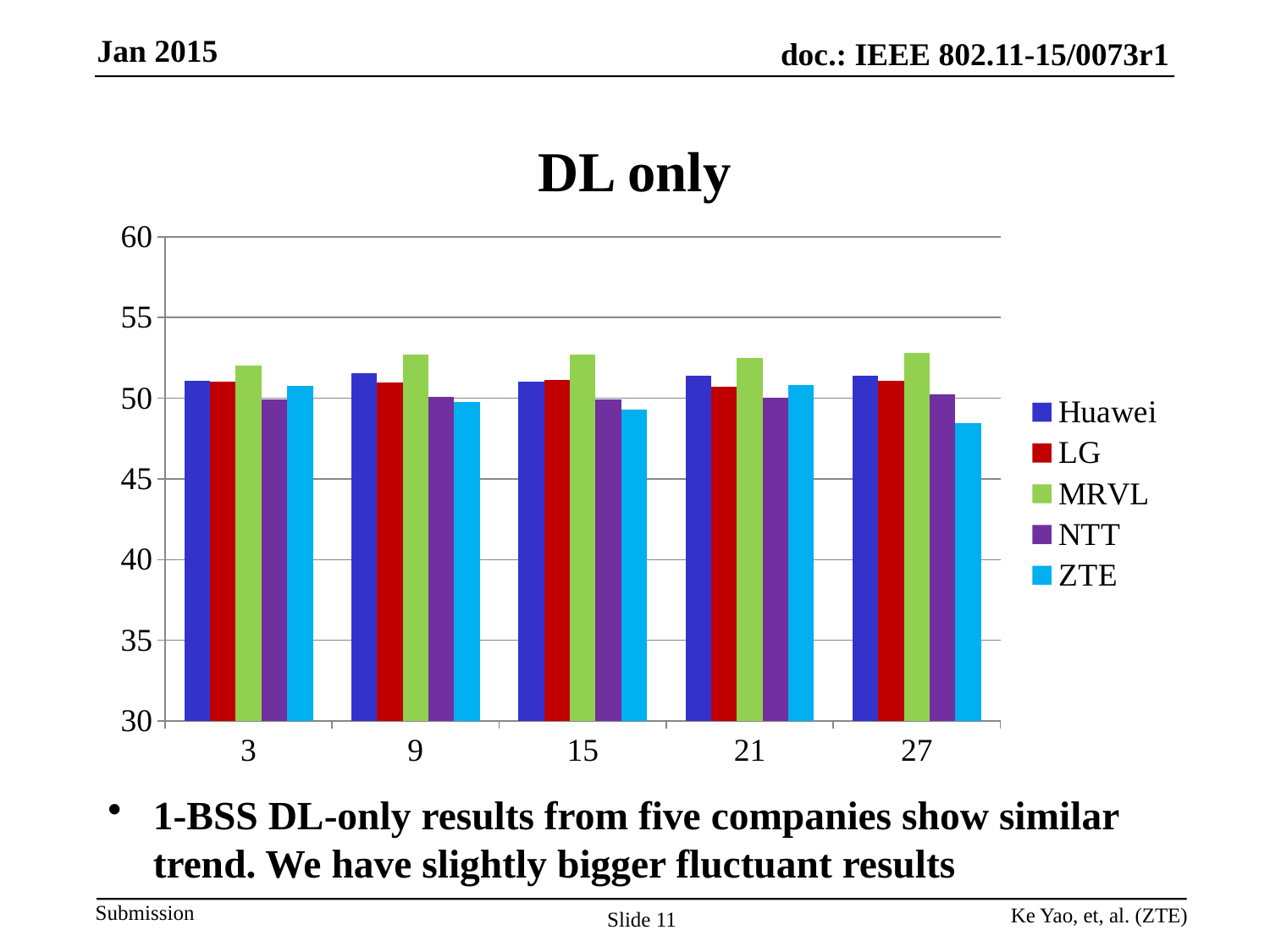
Which series has the lowest value at category 27? ZTE At category 15, which is larger: the value for MRVL or the value for NTT? MRVL How many categories are shown on the x axis? 5 Is the value for ZTE at category 27 greater or less than 50? less What is the title of the chart? DL only At category 27, which is larger: the value for MRVL or the value for ZTE? MRVL Which series has the highest value at category 9? MRVL How many series does the legend list? 5 Which series is represented by the green bars? MRVL Is the value for MRVL at category 15 greater or less than 50? greater What kind of chart is shown on the slide? bar chart Which series has the highest value at category 27? MRVL